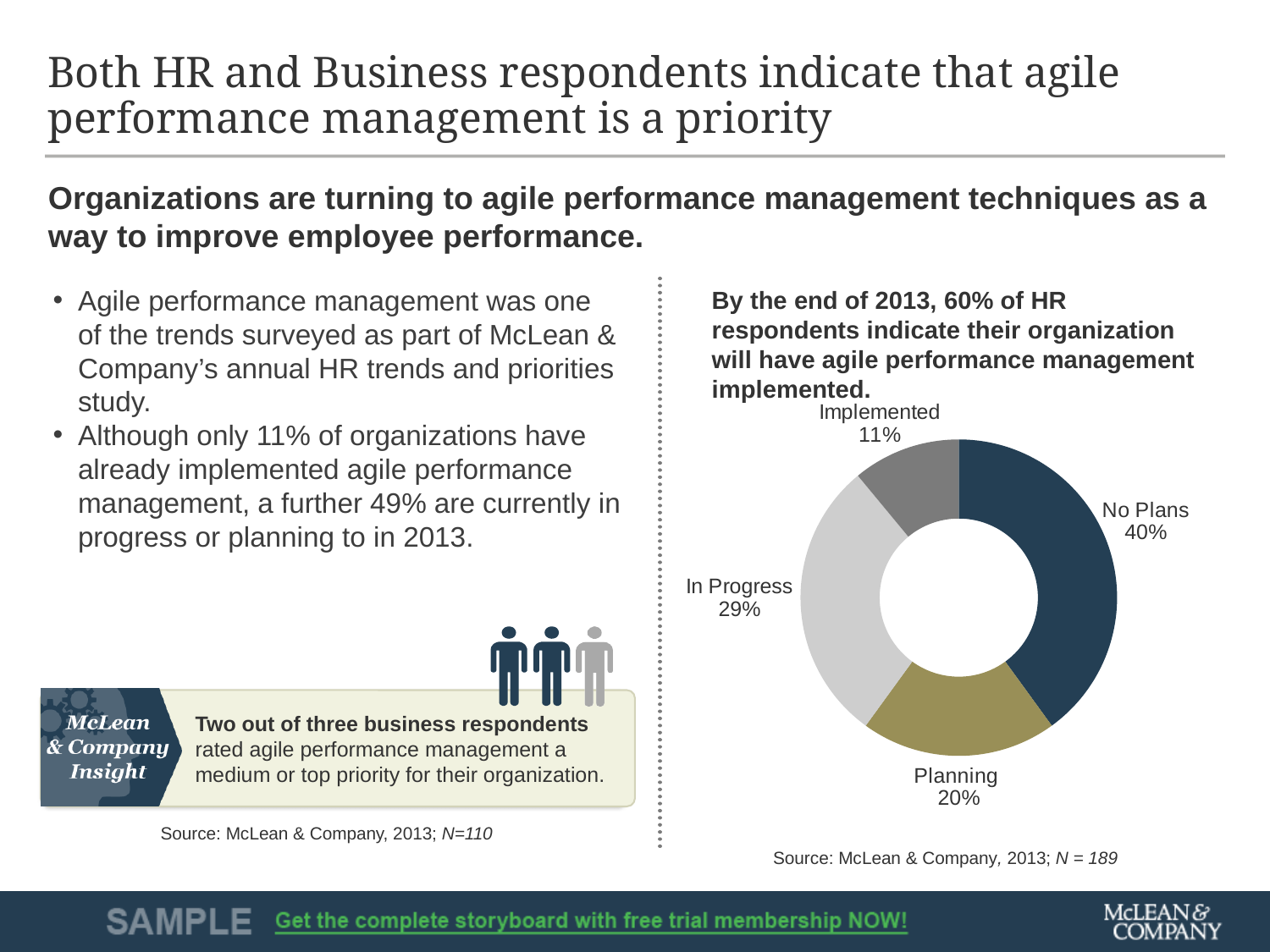
What percentage of HR respondents indicated 'Planning'? 20% What percentage of HR respondents indicated 'No Plans' in the donut chart? 40% How many categories are shown in the donut chart? 4 What is the combined share of 'In Progress' and 'Planning' in the donut chart? 49% What is the difference in percentage points between 'In Progress' and 'Planning'? 9 Which is larger, the share for 'In Progress' or the share for 'Planning'? In Progress What percentage of HR respondents indicated 'Implemented'? 11% What percentage of HR respondents indicated 'In Progress'? 29% What is the difference in percentage points between 'No Plans' and 'Implemented'? 29 What type of chart is used to show the HR respondents' agile performance management status? Donut (pie) chart Which category has the smallest share in the donut chart? Implemented Which category has the largest share in the donut chart? No Plans